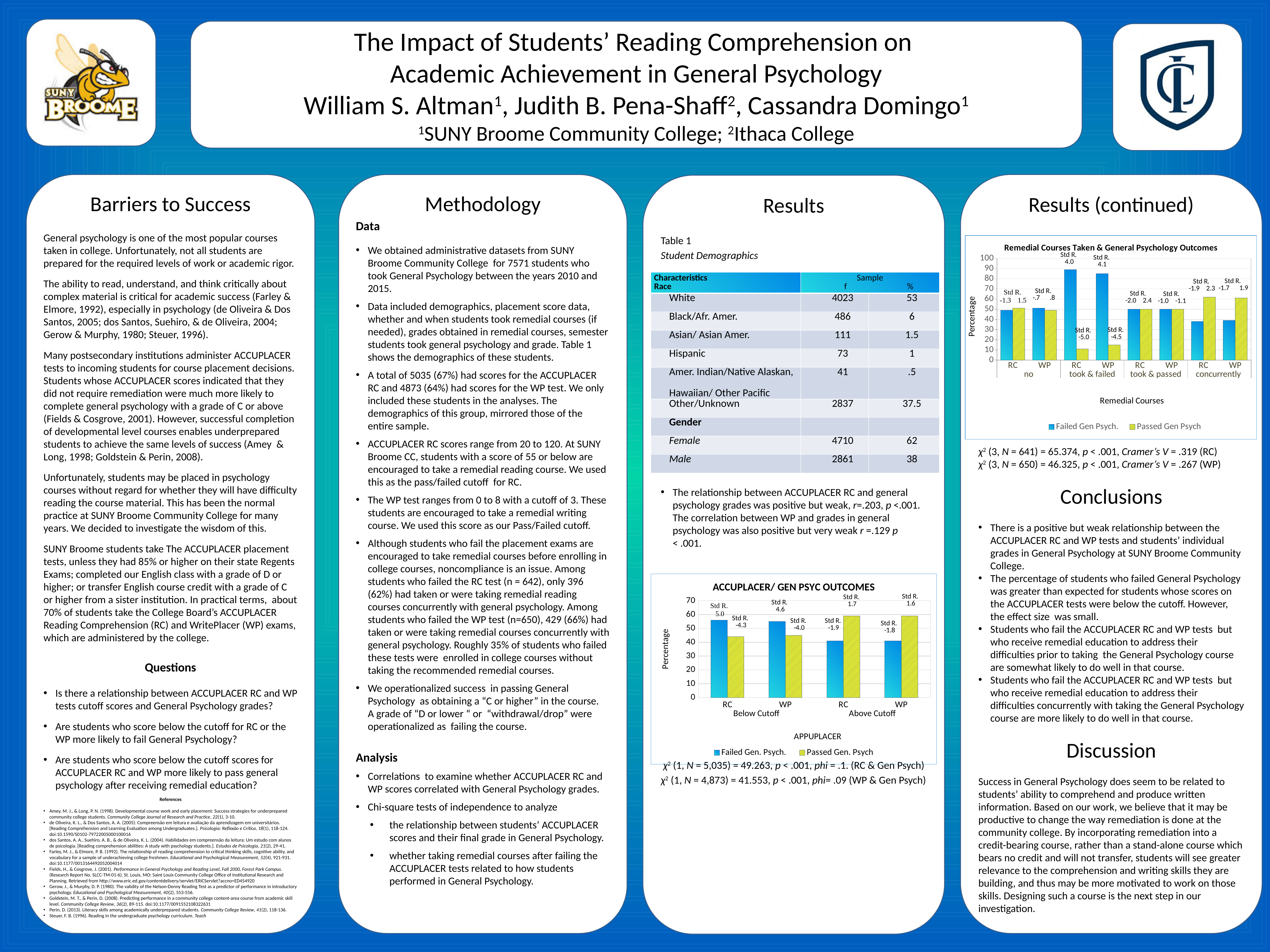
In the 'Remedial Courses Taken & General Psychology Outcomes' chart, is the Failed Gen Psych. value for RC under 'took & failed' greater or less than 80? greater In the 'Remedial Courses Taken & General Psychology Outcomes' chart, which bar is the lowest? Passed Gen Psych for RC, took & failed In the 'Remedial Courses Taken & General Psychology Outcomes' chart, for RC under 'concurrently', which is larger: Failed Gen Psych. or Passed Gen Psych? Passed Gen Psych In the 'ACCUPLACER/ GEN PSYC OUTCOMES' chart, for RC Below Cutoff, which is larger: Failed Gen. Psych. or Passed Gen. Psych? Failed Gen. Psych. In the 'ACCUPLACER/ GEN PSYC OUTCOMES' chart, how many series does the legend list? 2 In the 'Remedial Courses Taken & General Psychology Outcomes' chart, is the Passed Gen Psych value for RC under 'took & failed' greater or less than 20? less In the 'ACCUPLACER/ GEN PSYC OUTCOMES' chart, is the Passed Gen. Psych value for RC Above Cutoff greater or less than 50? greater What kind of chart is the 'Remedial Courses Taken & General Psychology Outcomes' chart? bar chart What is the x-axis title of the 'ACCUPLACER/ GEN PSYC OUTCOMES' chart? APPUPLACER In the 'Remedial Courses Taken & General Psychology Outcomes' chart, what Std R. value is printed above the Failed Gen Psych. bar for WP under 'took & failed'? 4.1 In the 'Remedial Courses Taken & General Psychology Outcomes' chart, which bar is the highest? Failed Gen Psych. for RC, took & failed In the 'ACCUPLACER/ GEN PSYC OUTCOMES' chart, what Std R. value is printed above the Failed Gen. Psych. bar for RC Below Cutoff? 5.0